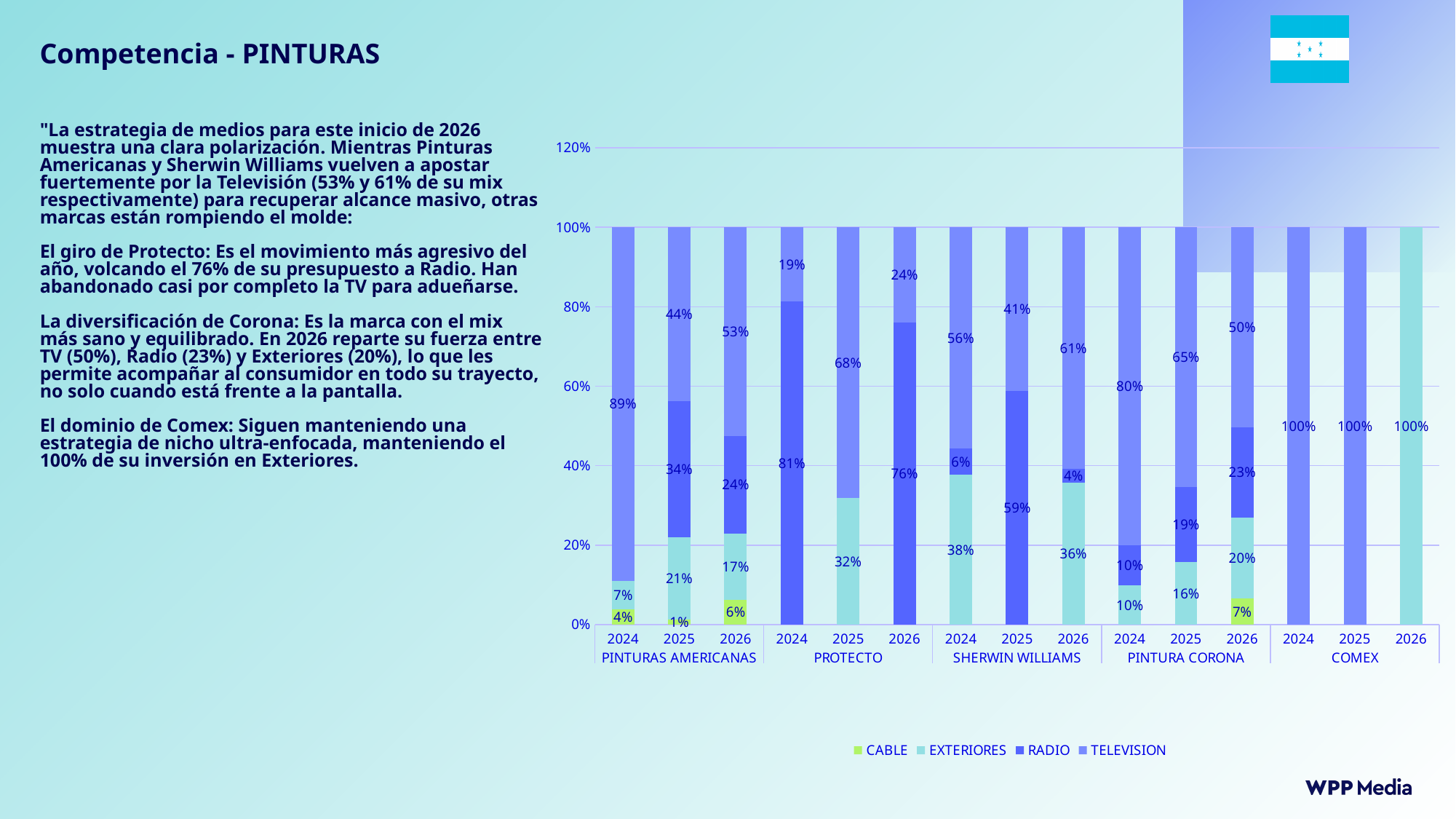
What share of Protecto's 2026 mix goes to RADIO? 76% What is the TELEVISION value for Sherwin Williams in 2026? 61% What is the difference between the TELEVISION value for Pintura Corona in 2024 and in 2026? 30% Which is larger: the RADIO value for Protecto in 2024 or the RADIO value for Sherwin Williams in 2025? Protecto 2024 What is the TELEVISION value for Pinturas Americanas in 2024? 89% How many brands are shown along the x axis? 5 What is the CABLE value for Pinturas Americanas in 2025? 1% What kind of chart is shown on the slide? stacked bar chart Which legend entry is shown in green? CABLE How many series does the legend list? 4 What is the EXTERIORES value for Pintura Corona in 2026? 20% Which brand-year bar has the highest RADIO value? Protecto 2024